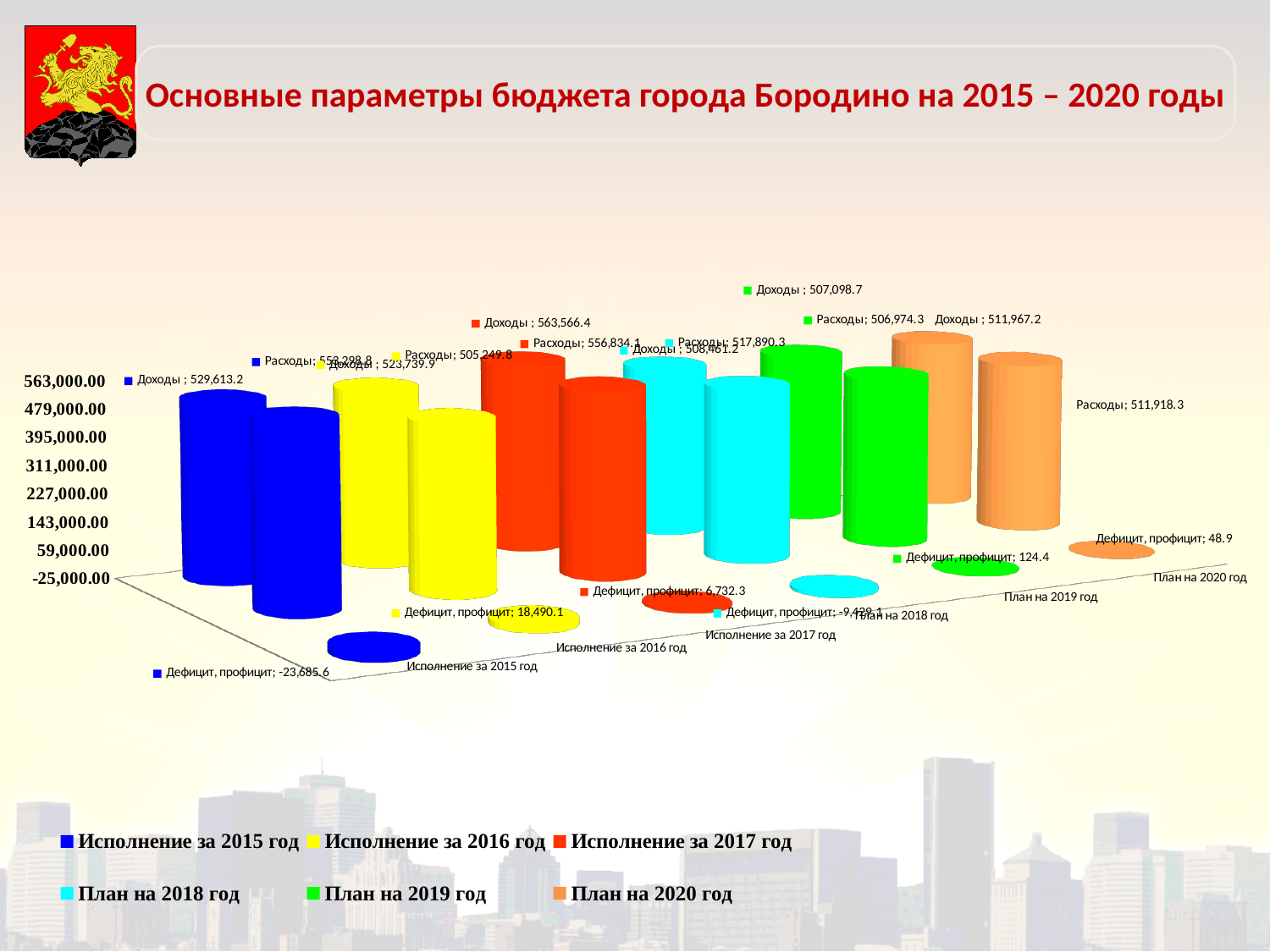
What is the value of Доходы for План на 2019 год? 507,098.7 What is the value of Доходы for Исполнение за 2017 год? 563,566.4 What is the value of Дефицит, профицит for План на 2020 год? 48.9 What is the value of Дефицит, профицит for Исполнение за 2016 год? 18,490.1 For План на 2018 год, which is larger: Доходы or Расходы? Расходы Which year has the highest Доходы value? Исполнение за 2017 год Is the value of Доходы for Исполнение за 2015 год greater or less than 479,000.00? greater What is the value of Расходы for План на 2020 год? 511,918.3 What kind of chart is shown on the slide? bar chart Which year has the lowest Дефицит, профицит value? Исполнение за 2015 год What is the difference between Доходы and Расходы for План на 2019 год? 124.4 How many series does the legend list? 6